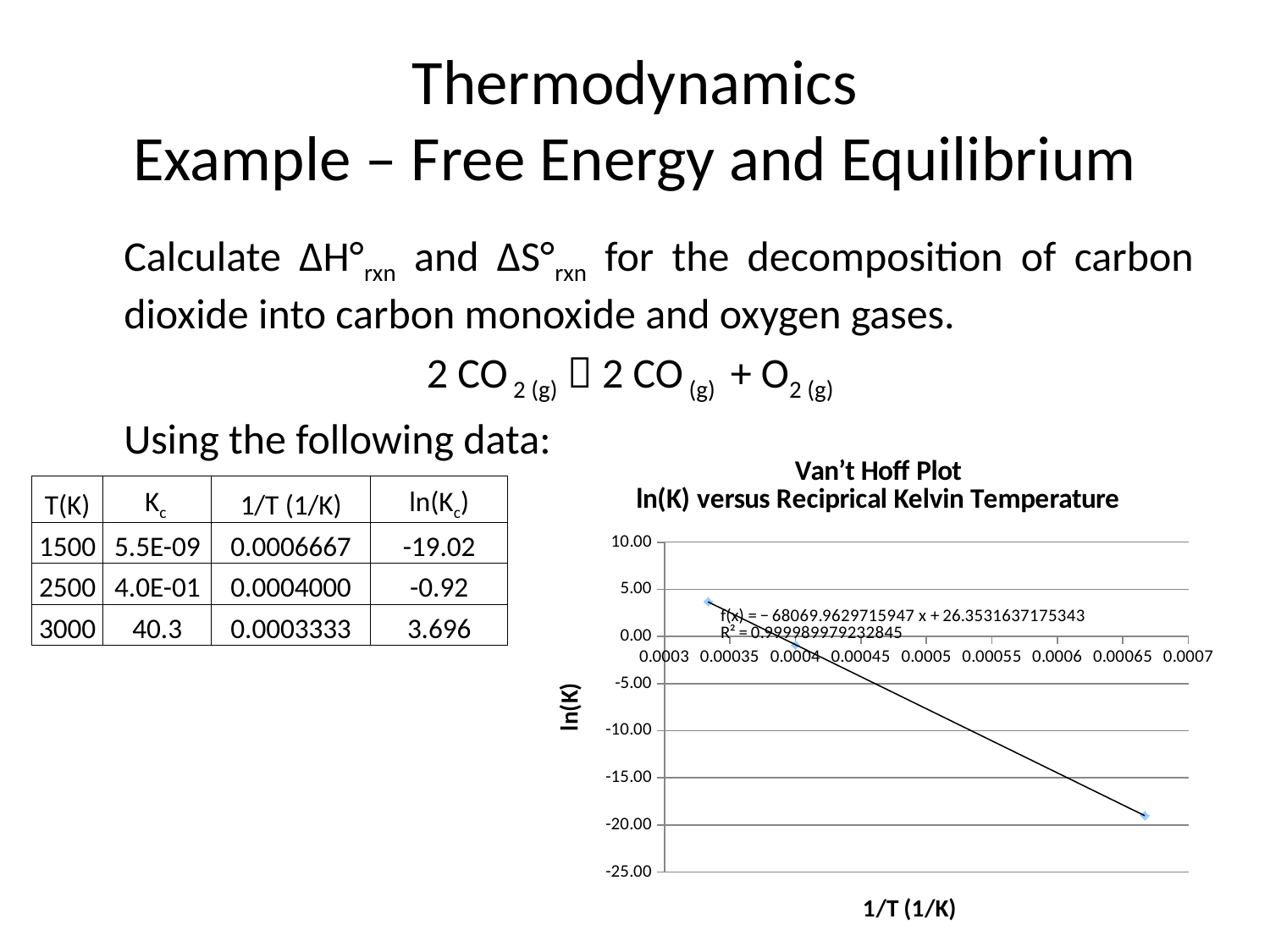
What is the R² value shown for the trendline in the Van't Hoff Plot? 0.999989979232845 In the Van't Hoff Plot, do the ln(K) values rise or fall as 1/T increases along the x axis? fall In the Van't Hoff Plot, is the ln(K) value of the rightmost data point (near 1/T = 0.00065) greater or less than -15.00? less In the Van't Hoff Plot, which data point has the lowest ln(K) value: the leftmost or the rightmost? the rightmost In the Van't Hoff Plot, is the ln(K) value of the leftmost data point (near 1/T = 0.00035) greater or less than 0.00? greater What is the label on the y axis of the Van't Hoff Plot? ln(K) How many data points are plotted in the Van't Hoff Plot? 3 What is the highest value shown on the y axis of the Van't Hoff Plot? 10.00 In the Van't Hoff Plot, is the ln(K) value of the rightmost data point greater or less than -10.00? less In the Van't Hoff Plot, which data point has the highest ln(K) value: the leftmost or the rightmost? the leftmost What kind of chart is the Van't Hoff Plot on the slide? scatter chart